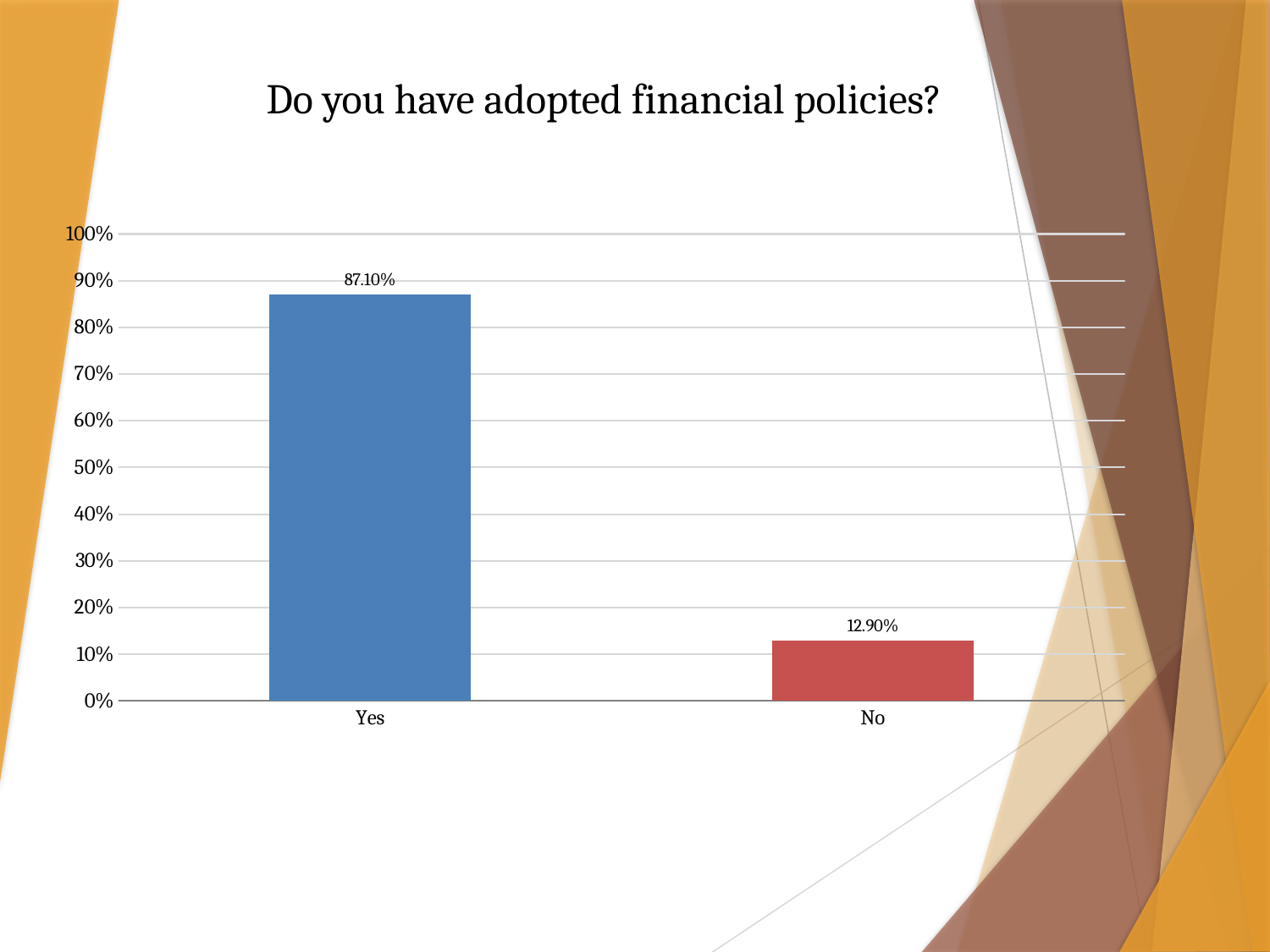
Which category has the highest value? Yes What is the value for No? 12.90% What is the value for Yes? 87.10% Which category has the lowest value? No What colour is the bar for No? red Is the value for Yes greater or less than 80%? greater What is the difference between the values for Yes and No? 74.20% What is the title of the chart? Do you have adopted financial policies? Is the value for No greater or less than 20%? less Which is larger, the value for Yes or the value for No? Yes What kind of chart is shown on the slide? bar chart How many categories are shown on the x axis? 2